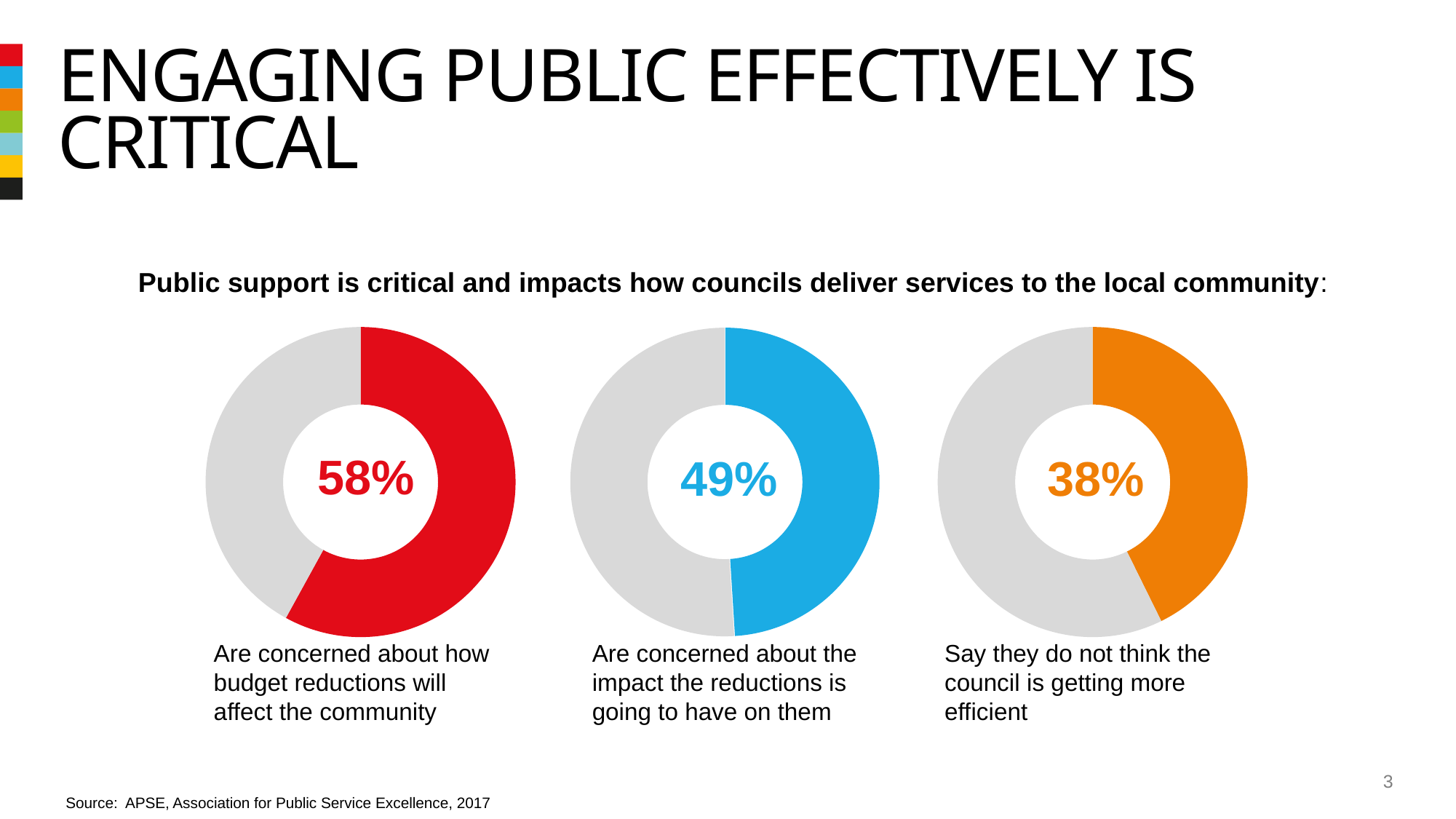
Which of the three doughnut charts shows the highest percentage? The left (red) chart, 58% What percentage is shown in the left (red) doughnut chart? 58% What type of chart is used on this slide? Doughnut (pie) chart What percentage is shown in the middle (blue) doughnut chart? 49% What is the difference between the percentage in the left (red) chart and the percentage in the middle (blue) chart? 9 percentage points Which is larger: the percentage concerned about how budget reductions will affect the community, or the percentage concerned about the impact on them? Concerned about how budget reductions will affect the community (58%) Which of the three doughnut charts shows the lowest percentage? The right (orange) chart, 38% How many doughnut charts are shown on the slide? 3 What percentage are concerned about the impact the reductions are going to have on them? 49% What percentage of people say they do not think the council is getting more efficient? 38% What percentage is shown in the right (orange) doughnut chart? 38% What is the difference between the percentage in the left (red) chart and the percentage in the right (orange) chart? 20 percentage points